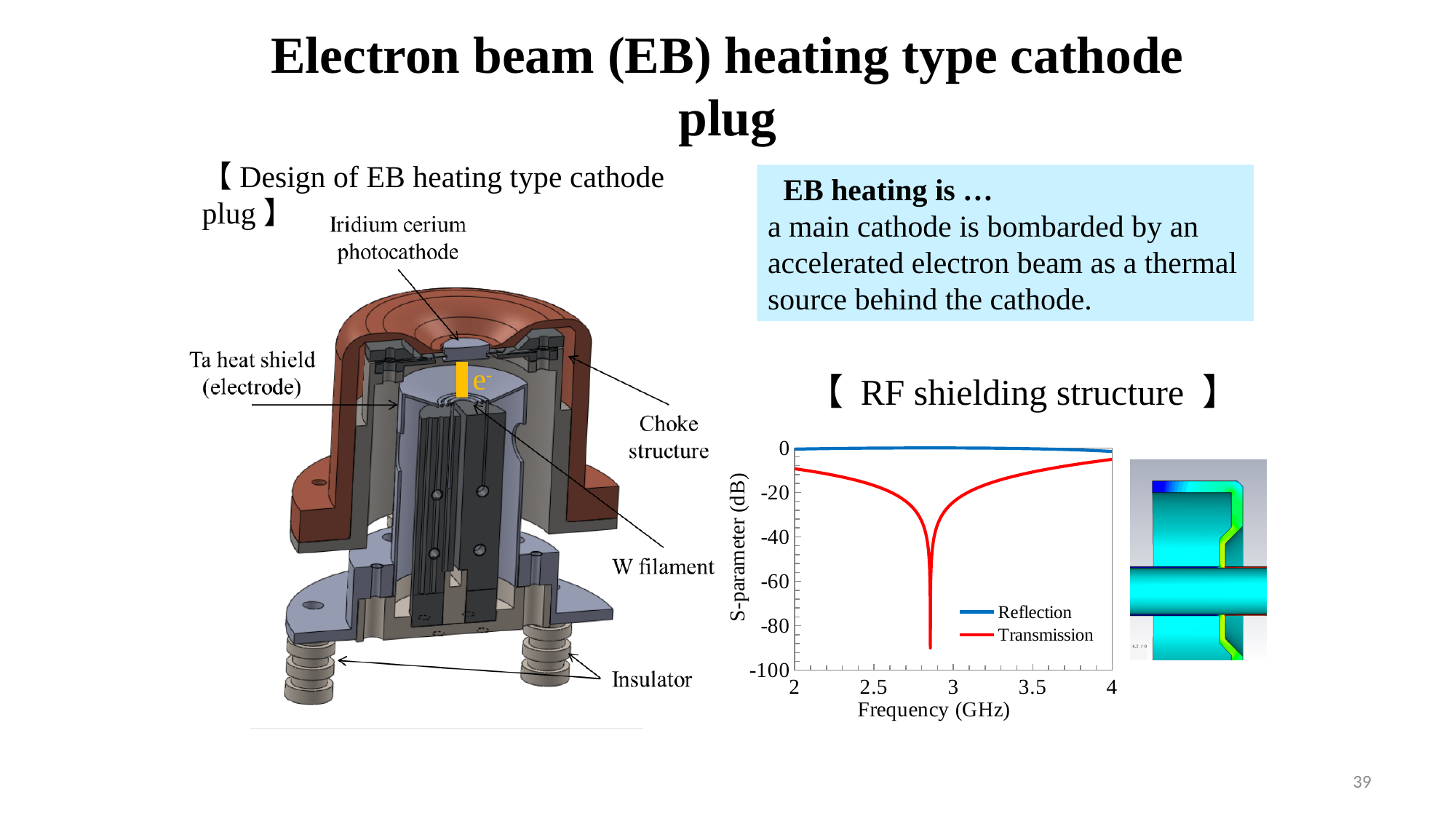
What kind of chart is shown under the heading 'RF shielding structure'? line chart In the S-parameter chart, does the Transmission curve rise or fall between 2 GHz and 2.8 GHz? fall In the S-parameter chart, is the Transmission value at 4 GHz greater or less than -20 dB? greater In the S-parameter chart, is the Transmission value at 2 GHz greater or less than -20 dB? greater How many series does the legend of the S-parameter chart list? 2 What are the two series named in the legend of the S-parameter chart? Reflection and Transmission In the S-parameter chart, which series has the higher value at 3 GHz, Reflection or Transmission? Reflection In the S-parameter chart, is the lowest Transmission value greater or less than -80 dB? less In the S-parameter chart, which series is drawn in red? Transmission In the S-parameter chart, does the Transmission curve rise or fall between 3 GHz and 4 GHz? rise What is the label of the x axis of the S-parameter chart? Frequency (GHz)